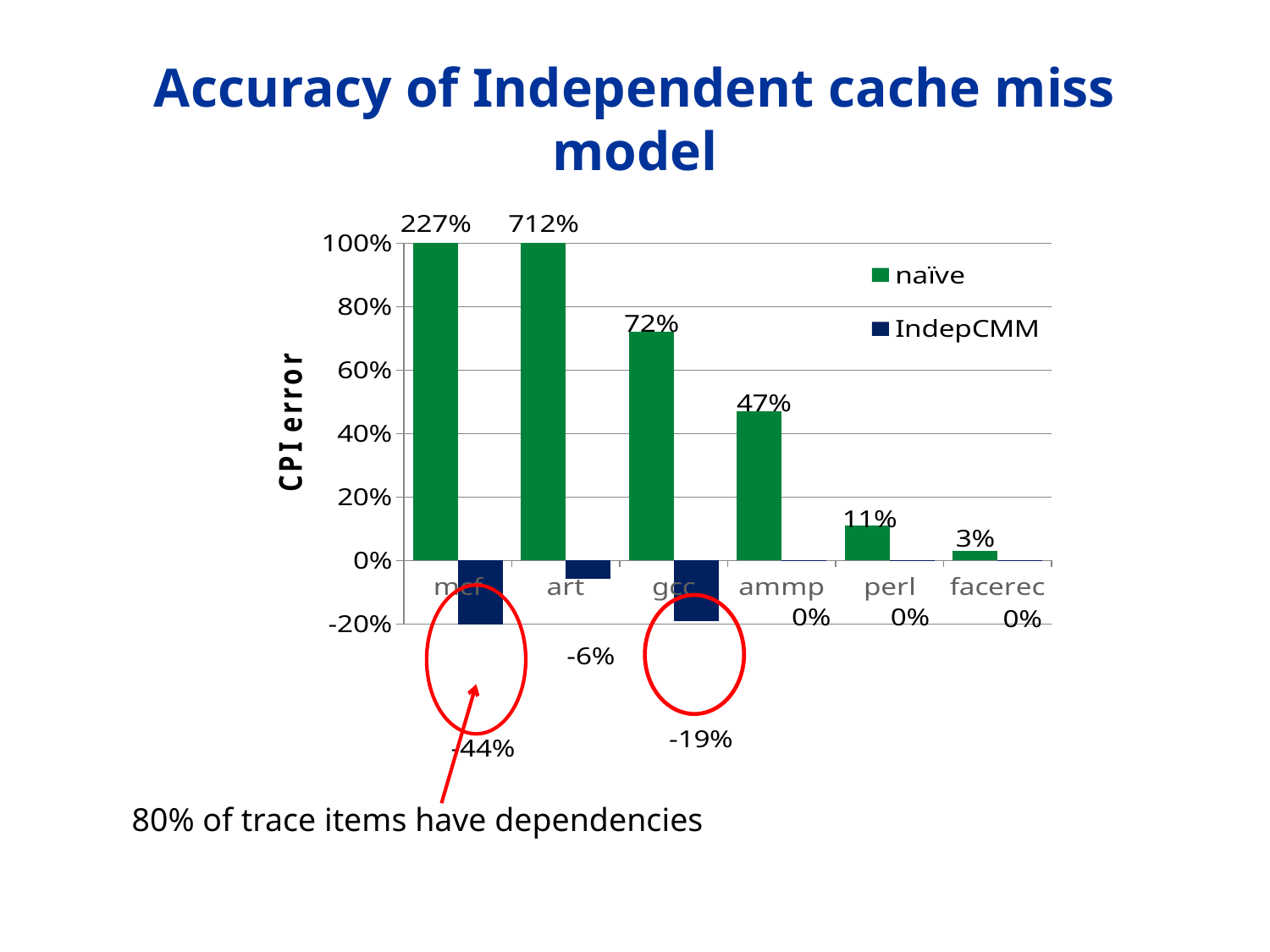
What is the difference between the naïve CPI error for art and for mcf? 485% How many series does the legend list? 2 What is the label of the y axis? CPI error What is the IndepCMM CPI error for gcc? -19% What is the IndepCMM CPI error for mcf? -44% What is the naïve CPI error for ammp? 47% Which benchmark has the lowest naïve CPI error? facerec Which benchmark has the highest naïve CPI error? art How many benchmarks are shown on the x axis? 6 What kind of chart is shown on the slide? bar chart Which is larger, the naïve CPI error for gcc or for ammp? gcc What is the naïve CPI error for art? 712%